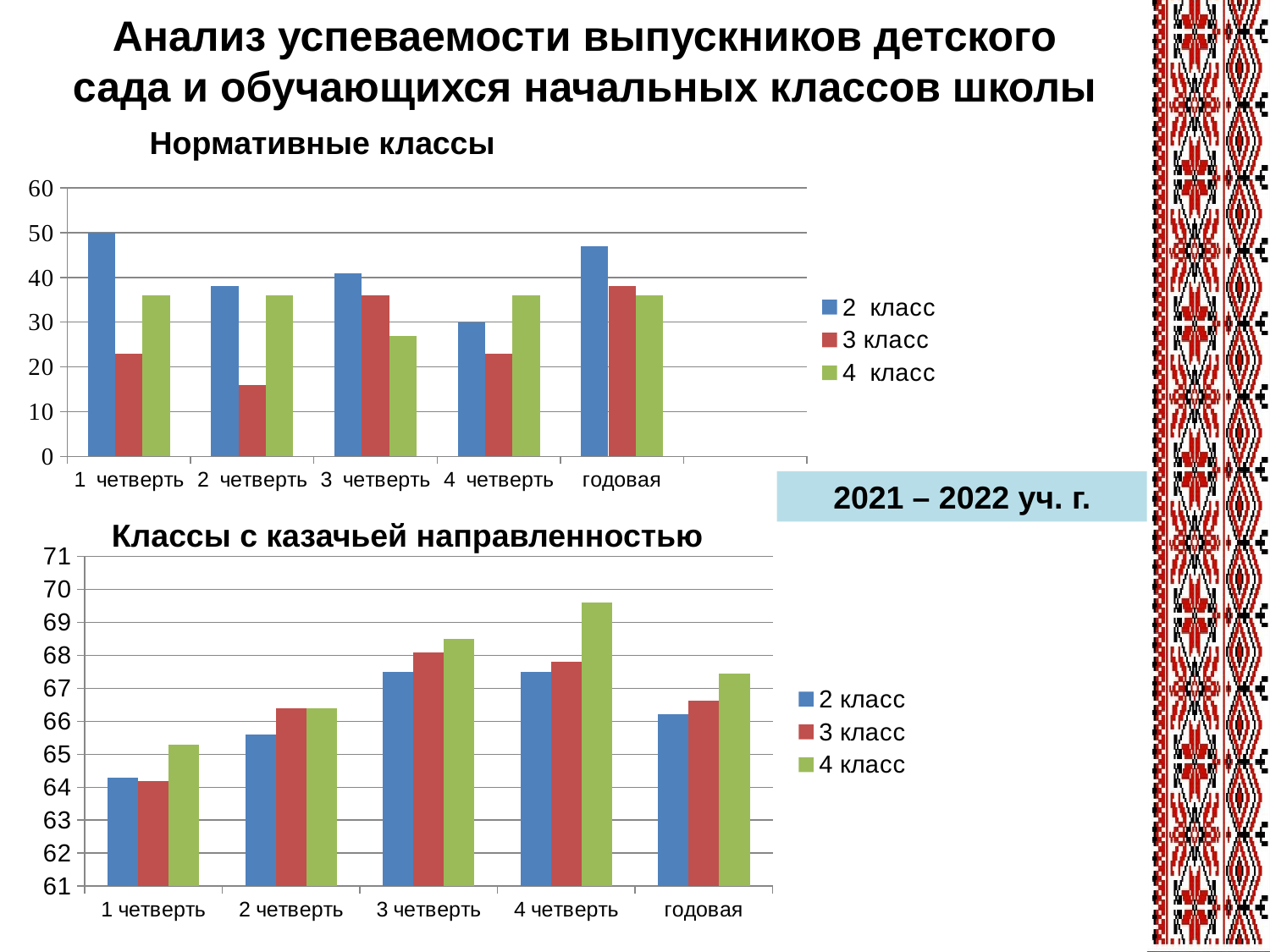
In the top chart "Нормативные классы", is the value for 2 класс in 3 четверть greater or less than 40? greater In the bottom chart "Классы с казачьей направленностью", is the value for 2 класс in 1 четверть greater or less than 65? less How many series does the legend of the top chart "Нормативные классы" list? 3 How many categories are shown on the x axis of the bottom chart "Классы с казачьей направленностью"? 5 In the top chart "Нормативные классы", which category has the lowest value for the 3 класс series? 2 четверть In the top chart "Нормативные классы", which is larger in 4 четверть: the value for 2 класс or for 4 класс? 4 класс In the bottom chart "Классы с казачьей направленностью", is the value for 4 класс in 4 четверть greater or less than 69? greater In the top chart "Нормативные классы", which category has the highest value for the 2 класс series? 1 четверть In the bottom chart "Классы с казачьей направленностью", which is larger in 3 четверть: the value for 2 класс or for 3 класс? 3 класс In the bottom chart "Классы с казачьей направленностью", which category has the highest value for the 4 класс series? 4 четверть What kind of chart is the top chart titled "Нормативные классы"? bar chart